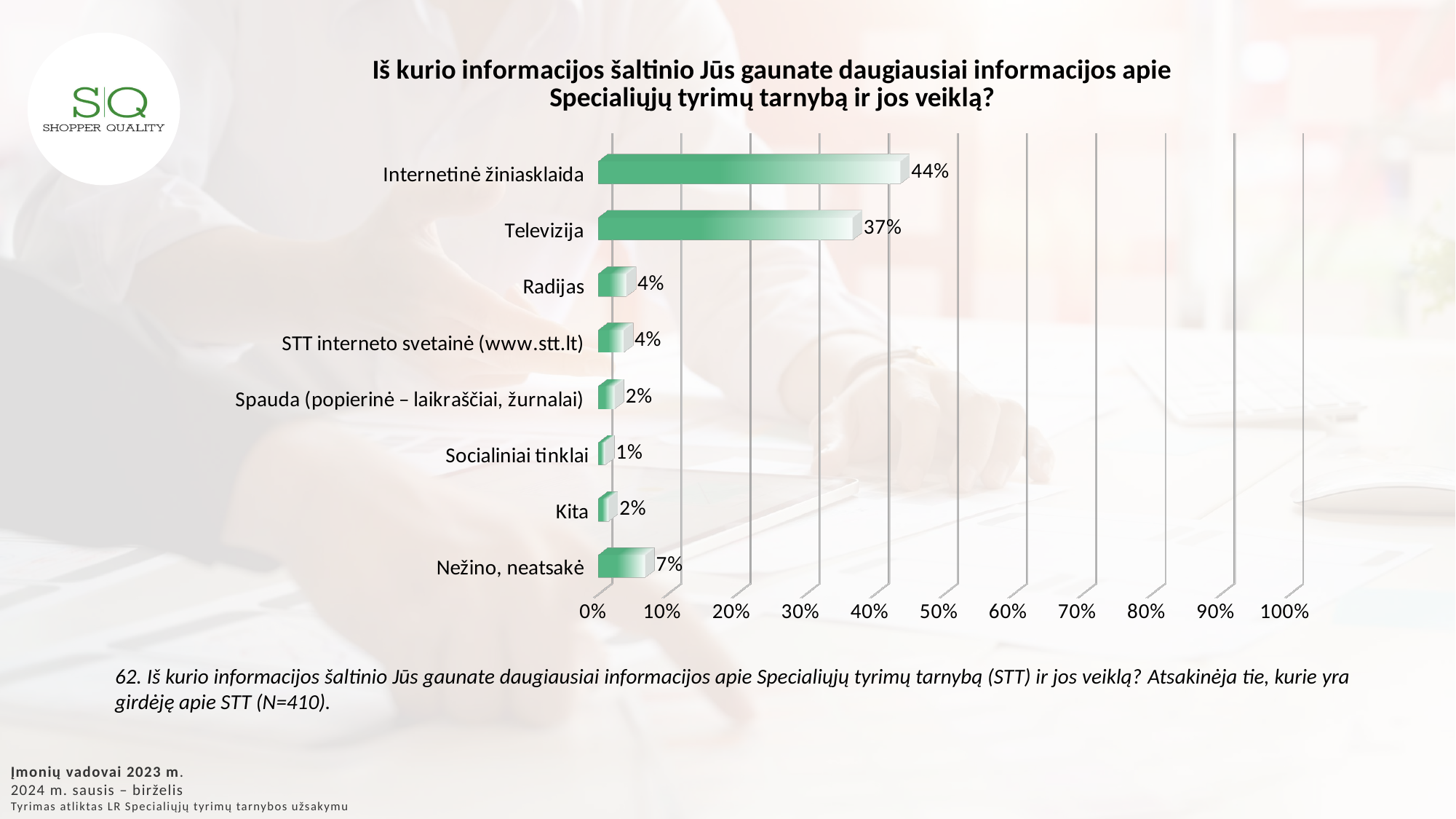
Which category has the lowest value? Socialiniai tinklai Is the value for Televizija greater or less than 30%? greater Which is larger, the value for Nežino, neatsakė or the value for Radijas? Nežino, neatsakė What is the value for Spauda (popierinė – laikraščiai, žurnalai)? 2% What is the value for Televizija? 37% What is the difference between the values for Internetinė žiniasklaida and Televizija? 7% Which category has the highest value? Internetinė žiniasklaida What kind of chart is shown on the slide? bar chart What is the value for Internetinė žiniasklaida? 44% How many categories are shown in the chart? 8 What is the value for Nežino, neatsakė? 7% What is the value for Socialiniai tinklai? 1%